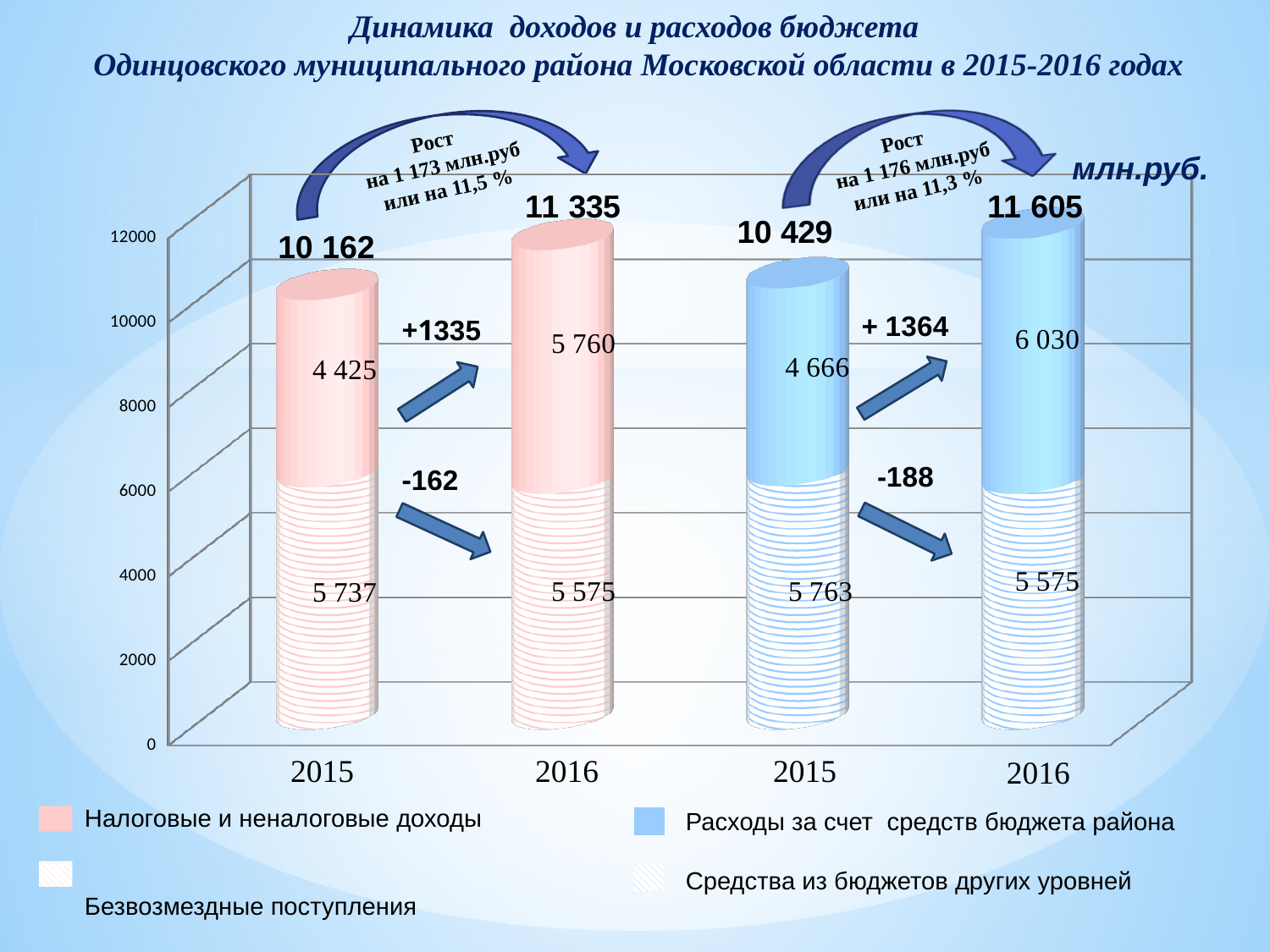
What is the value of 'Средства из бюджетов других уровней' for 2015? 5 763 By how much did 'Налоговые и неналоговые доходы' change from 2015 to 2016? +1335 What is the value of 'Налоговые и неналоговые доходы' for 2015? 4 425 Which of the four bars has the highest total? 2016 expenses (11 605) How many legend entries does the chart have? 4 What is the total of the expenses bar for 2015 (the third bar)? 10 429 What is the total of the income bar for 2016 (the second bar)? 11 335 What type of chart is shown on the slide? Stacked bar chart By how much did 'Средства из бюджетов других уровней' change from 2015 to 2016? -188 Which is larger: 'Расходы за счет средств бюджета района' in 2015 or in 2016? 2016 What is the value of 'Расходы за счет средств бюджета района' for 2016? 6 030 What is the value of 'Безвозмездные поступления' for 2016? 5 575